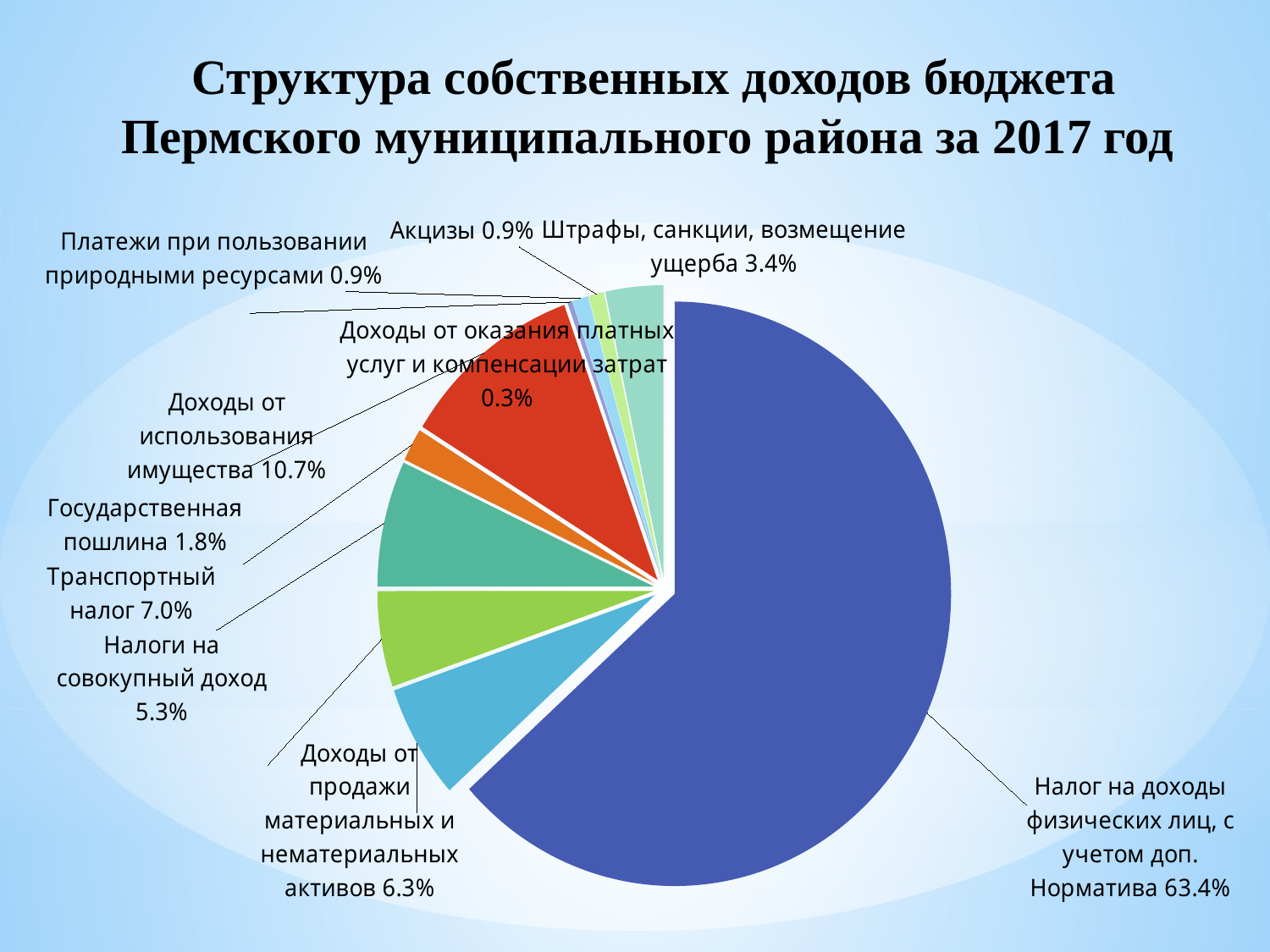
Which is larger: "Доходы от продажи материальных и нематериальных активов" or "Налоги на совокупный доход"? Доходы от продажи материальных и нематериальных активов How many slices does the pie chart have? 10 What is the value shown for "Транспортный налог"? 7.0% Which category has the smallest share of the pie? Доходы от оказания платных услуг и компенсации затрат What is the title of the slide? Структура собственных доходов бюджета Пермского муниципального района за 2017 год Which category has the largest share of the pie? Налог на доходы физических лиц, с учетом доп. Норматива What is the value shown for "Штрафы, санкции, возмещение ущерба"? 3.4% What is the value shown for "Государственная пошлина"? 1.8% What share of the pie does "Налог на доходы физических лиц, с учетом доп. Норматива" have? 63.4% What is the value shown for "Доходы от использования имущества"? 10.7% What is the difference between the shares of "Доходы от использования имущества" and "Транспортный налог"? 3.7% What kind of chart is shown on the slide? Pie chart